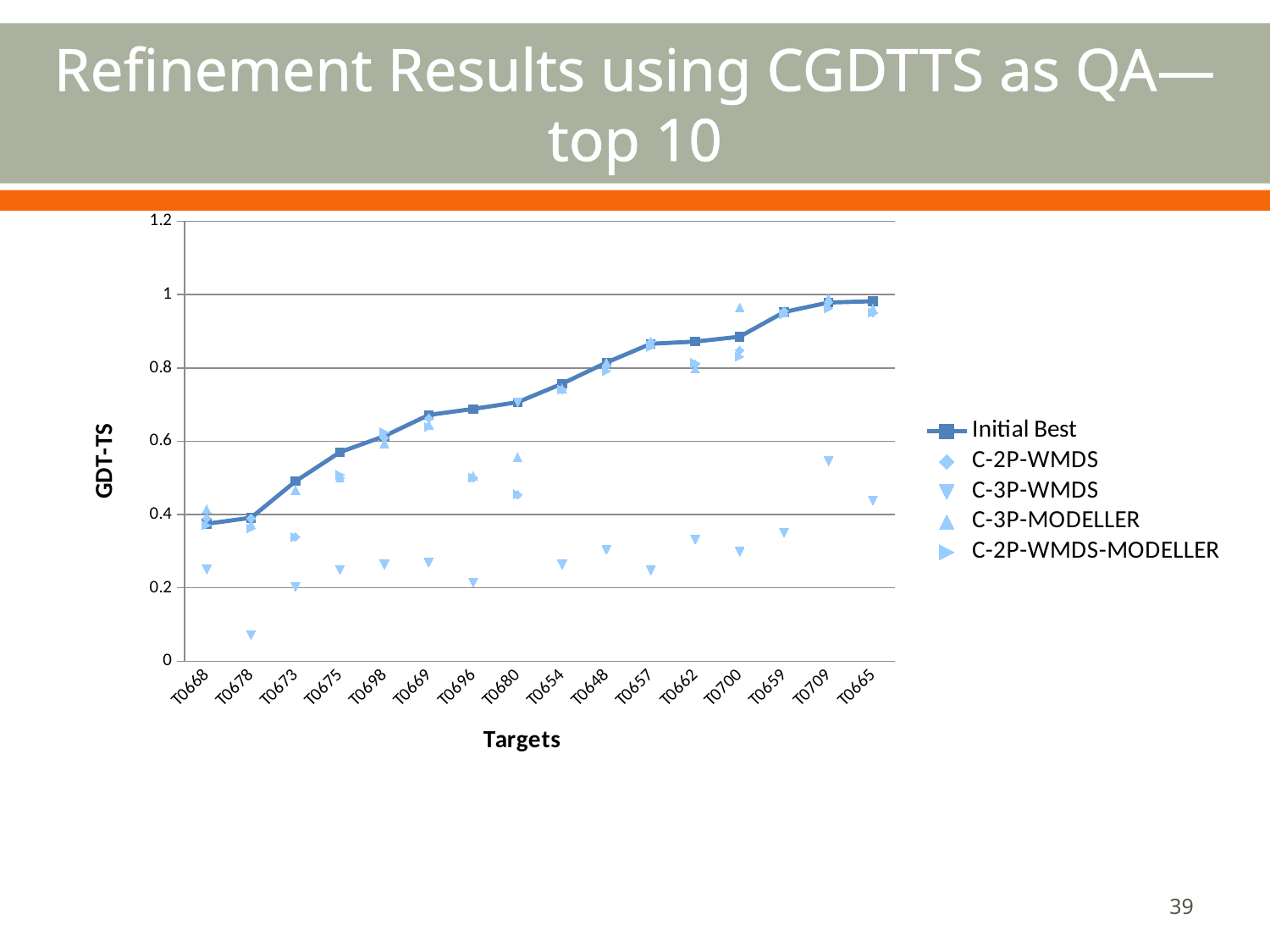
How many targets are shown along the x axis? 16 Which is larger, the Initial Best value for T0665 or for T0668? T0665 Is the Initial Best value for T0668 greater or less than 0.4? less Is the C-3P-WMDS value for T0678 greater or less than 0.2? less What kind of chart is shown on the slide? Line chart with scatter markers Does the Initial Best series rise or fall from T0668 to T0665 along the x axis? Rises Is the Initial Best value for T0709 greater or less than 0.8? greater What is the label of the y axis? GDT-TS How many series does the legend list? 5 Which series is drawn as a solid line with square markers? Initial Best